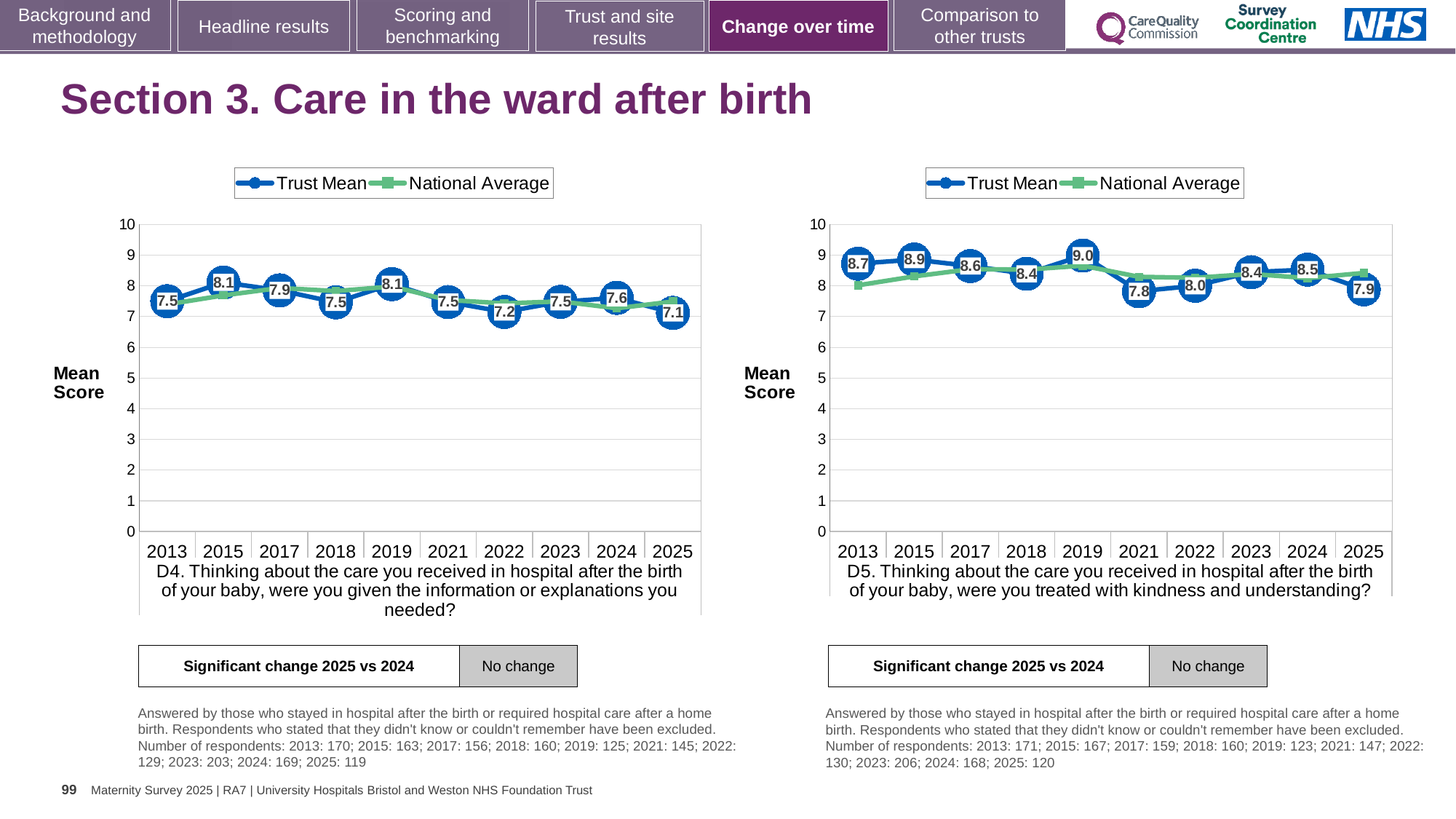
In the right chart (D5), what is the Trust Mean score for 2019? 9.0 In the right chart (D5), what is the difference between the Trust Mean scores for 2019 and 2021? 1.2 In the left chart (D4), which year has the lowest Trust Mean score? 2025 What does the box below the right chart (D5) say about significant change 2025 vs 2024? No change In the left chart (D4), is the Trust Mean score for 2015 higher or lower than for 2018? higher In the right chart (D5), which year has the highest Trust Mean score? 2019 In the left chart (D4), what is the Trust Mean score for 2025? 7.1 What type of chart is used for D4 on the left? Line chart In the right chart (D5), which year has the lowest Trust Mean score? 2021 How many years are plotted on the x axis of the left chart (D4)? 10 In the left chart (D4), what is the Trust Mean score for 2022? 7.2 How many series does the legend of the right chart (D5) list? 2